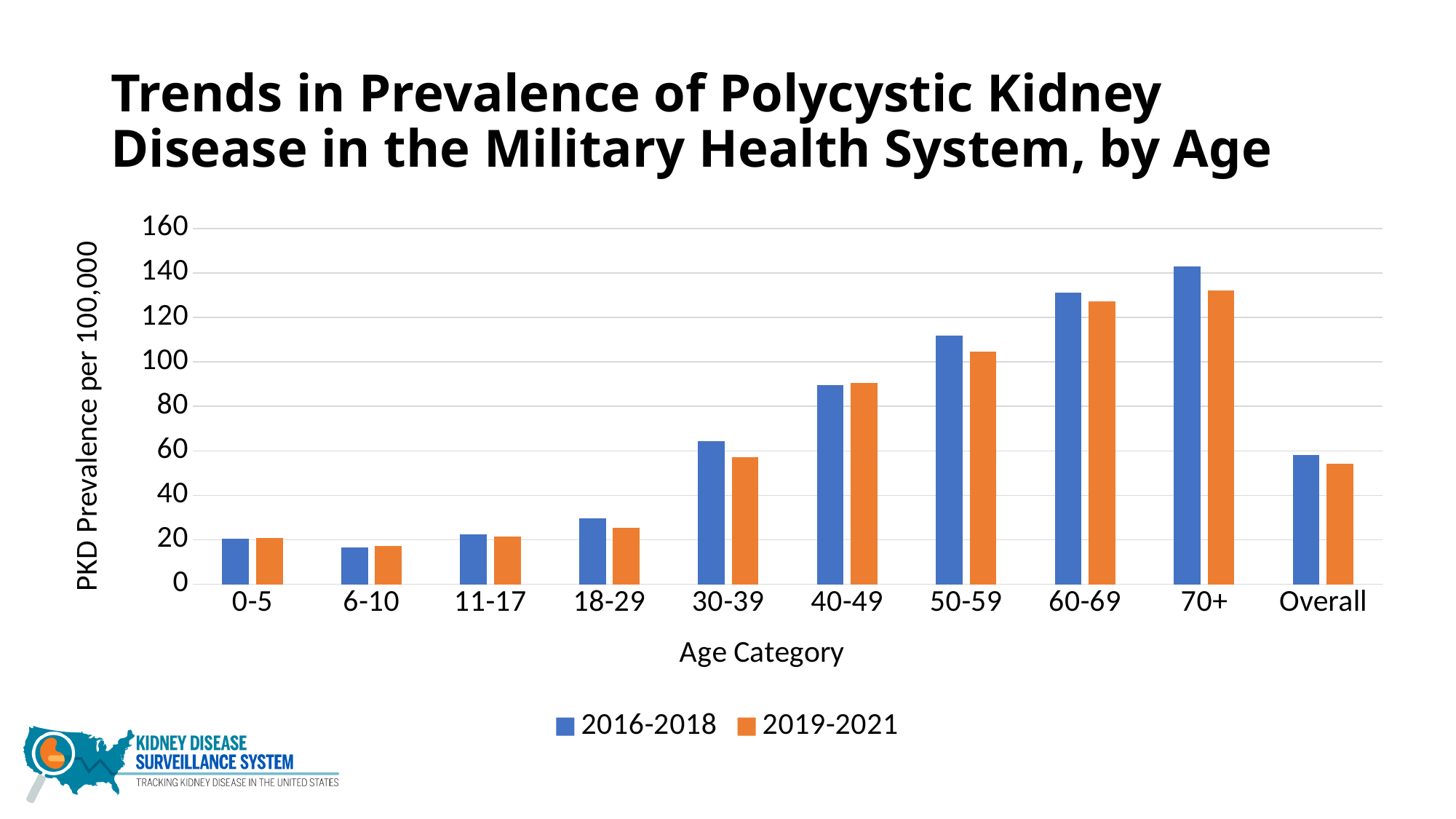
For the 30-39 age category, which period has the larger PKD prevalence, 2016-2018 or 2019-2021? 2016-2018 How many series does the legend list? 2 How many age categories are shown on the x axis? 10 Is the 2016-2018 value for the 50-59 age category greater or less than 100? greater What kind of chart is shown on the slide? Bar chart Does PKD prevalence generally rise or fall as age increases from 0-5 to 70+? Rise Which age category has the highest PKD prevalence for 2016-2018? 70+ Is the 2016-2018 value for the 18-29 age category greater or less than 40? less What is the label of the y axis? PKD Prevalence per 100,000 Which age category has the lowest PKD prevalence for 2019-2021? 6-10 Is the 2019-2021 value for the 70+ age category greater or less than 120? greater For the 70+ age category, which period has the larger PKD prevalence, 2016-2018 or 2019-2021? 2016-2018